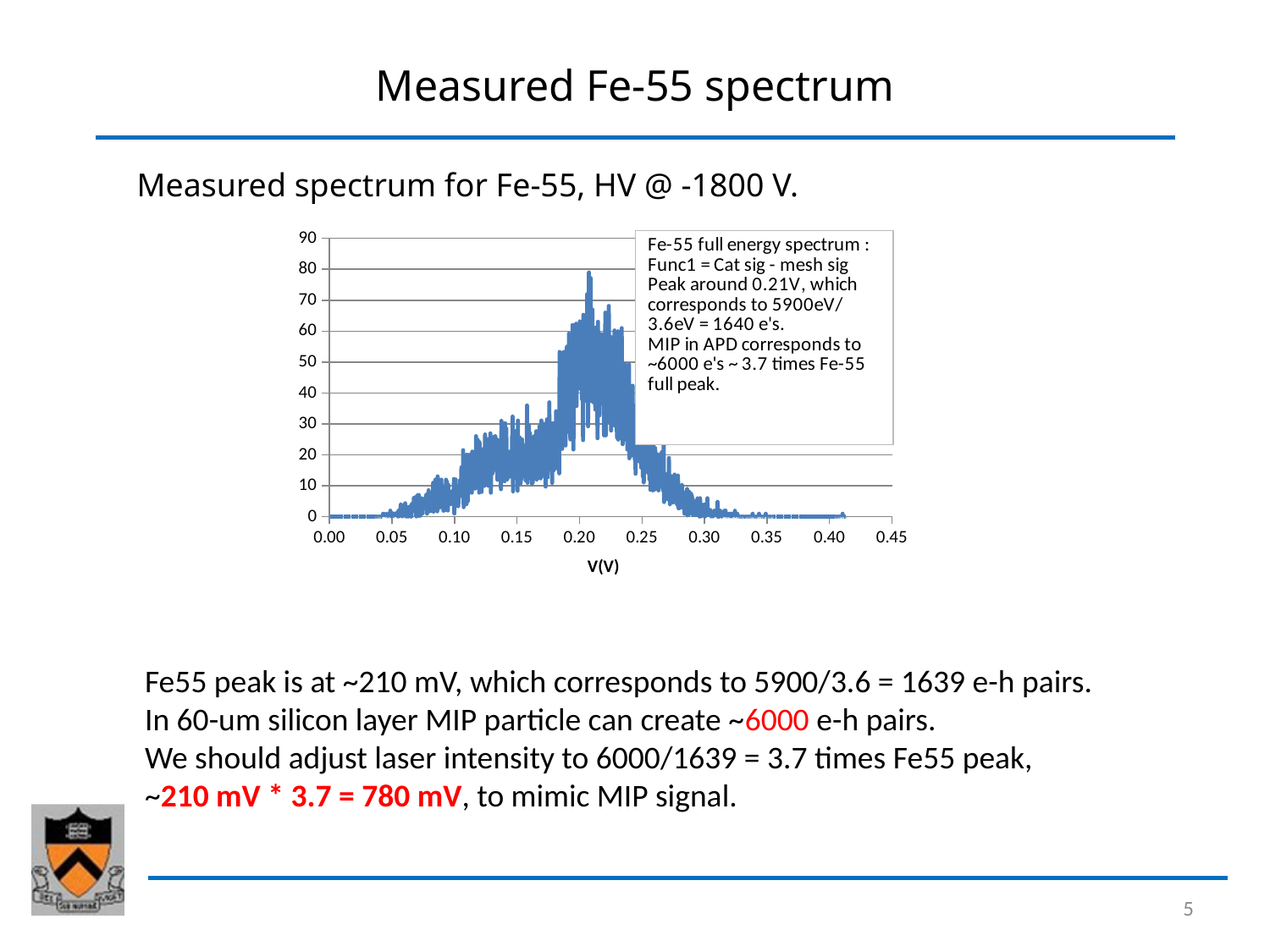
What is the largest tick value shown on the x axis of the chart? 0.45 Does the spectrum generally rise or fall between 0.05 V and 0.20 V on the x axis? rise What is the label of the x axis of the chart? V(V) What is the highest value shown on the y axis of the chart? 90 What kind of chart is shown on the slide? line chart Is the spectrum value at 0.20 V larger or smaller than the value at 0.35 V? larger Is the value of the spectrum at 0.05 V greater or less than 10? less Is the maximum value of the spectrum greater or less than 70? greater Does the spectrum generally rise or fall between 0.25 V and 0.35 V on the x axis? fall According to the annotation on the chart, around what voltage is the Fe-55 peak? 0.21V Is the value of the spectrum at 0.40 V greater or less than 10? less